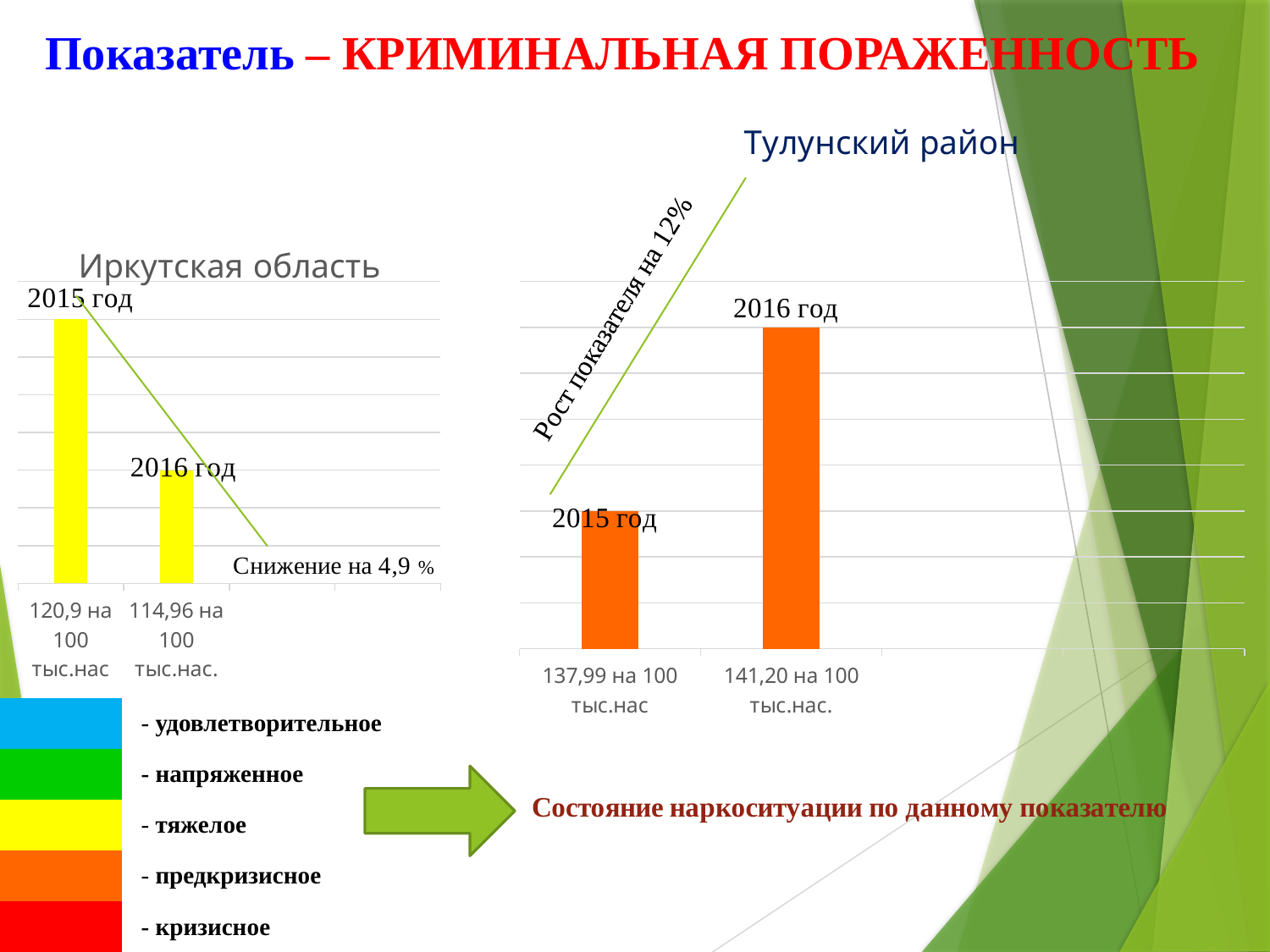
In the 'Тулунский район' chart, what is the value for 2016 год? 141,20 на 100 тыс.нас. In the 'Иркутская область' chart, which year has the higher bar? 2015 год In the 'Тулунский район' chart, which year has the lower bar? 2015 год In the 'Иркутская область' chart, what is the value for 2015 год? 120,9 на 100 тыс.нас In the 'Тулунский район' chart, what is the value for 2015 год? 137,99 на 100 тыс.нас In the 'Иркутская область' chart, by how much does the value for 2015 год exceed the value for 2016 год? 5,94 Is the 2016 год value in the 'Тулунский район' chart larger or smaller than the 2016 год value in the 'Иркутская область' chart? larger In the 'Тулунский район' chart, do the values rise or fall from 2015 год to 2016 год? rise What type of chart is the 'Иркутская область' chart? bar chart In the 'Иркутская область' chart, what is the value for 2016 год? 114,96 на 100 тыс.нас. In the 'Тулунский район' chart, what is the difference between the 2016 год and 2015 год values? 3,21 How many bars does the 'Тулунский район' chart show? 2